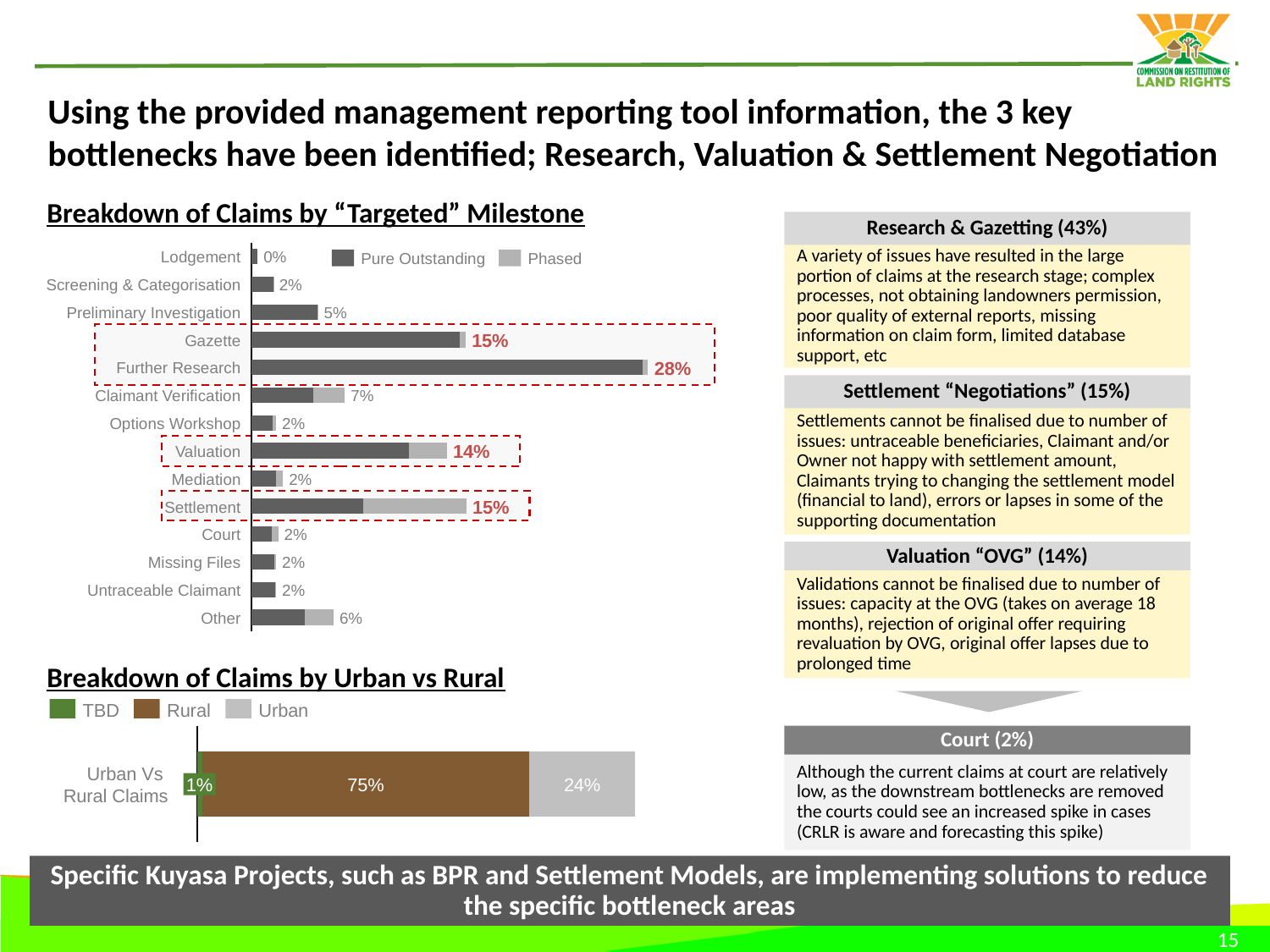
In the 'Breakdown of Claims by "Targeted" Milestone' chart, what is the value for Valuation? 14% In the 'Breakdown of Claims by Urban vs Rural' chart, what is the value for Rural? 75% In the 'Breakdown of Claims by "Targeted" Milestone' chart, what is the difference between the values for Further Research and Gazette? 13% In the 'Breakdown of Claims by Urban vs Rural' chart, what is the value for Urban? 24% In the 'Breakdown of Claims by "Targeted" Milestone' chart, which milestone has the lowest value? Lodgement In the 'Breakdown of Claims by "Targeted" Milestone' chart, which is larger, the value for Settlement or the value for Claimant Verification? Settlement How many milestone categories are shown in the 'Breakdown of Claims by "Targeted" Milestone' chart? 14 In the 'Breakdown of Claims by "Targeted" Milestone' chart, which milestone has the highest value? Further Research In the 'Breakdown of Claims by "Targeted" Milestone' chart, what is the value for Further Research? 28% How many series does the legend of the 'Breakdown of Claims by Urban vs Rural' chart list? 3 How many series does the legend of the 'Breakdown of Claims by "Targeted" Milestone' chart list? 2 What kind of chart is the 'Breakdown of Claims by "Targeted" Milestone' chart? Bar chart